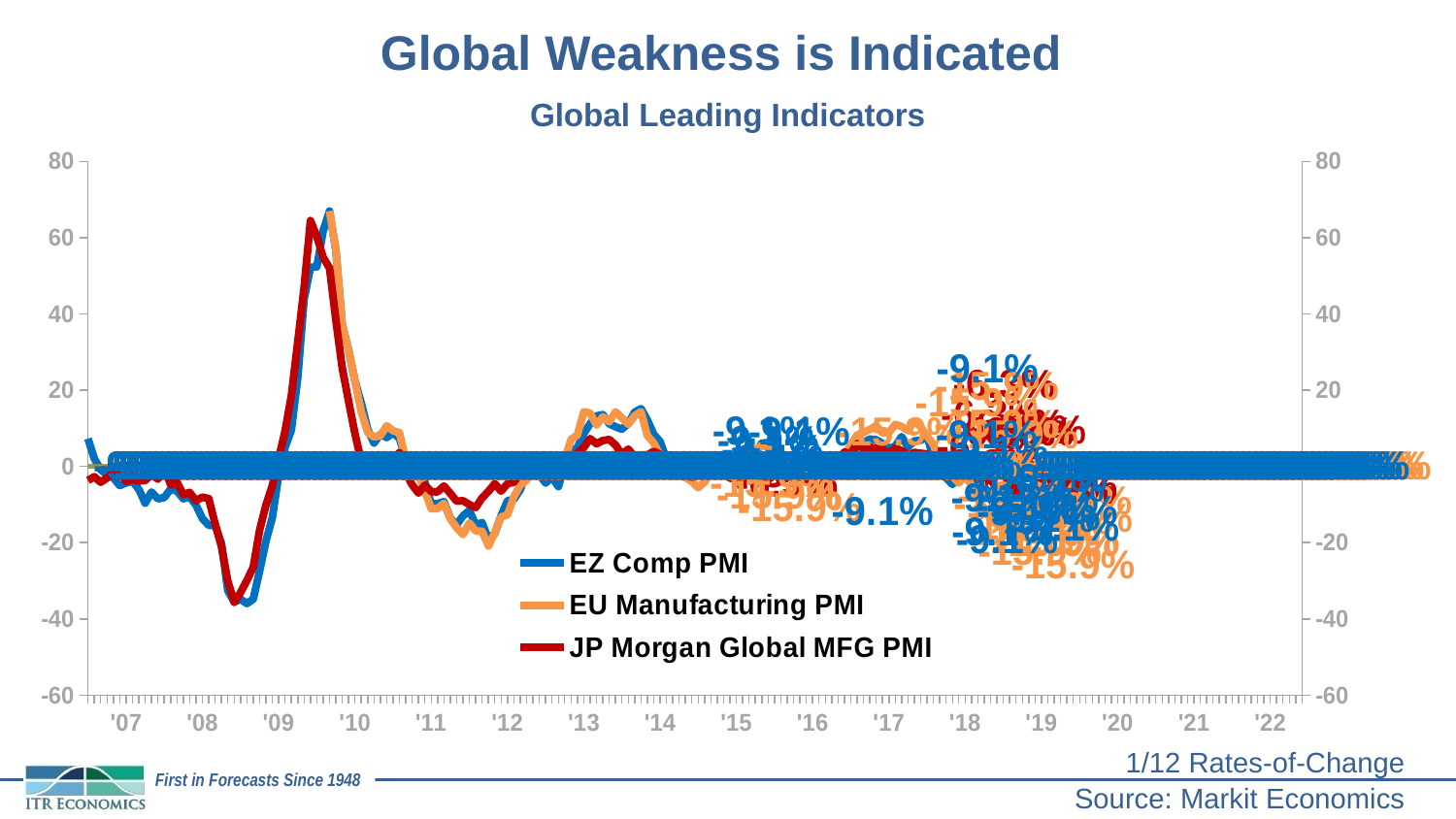
Is the peak value of JP Morgan Global MFG PMI around '09 greater or less than 40? greater What is the highest value shown on the y axis? 80 Which series is drawn in red in the chart? JP Morgan Global MFG PMI Do the series rise or fall from their trough around '08-'09 to their peak around '09-'10? rise How many series does the legend list? 3 Is the lowest value of EZ Comp PMI around '08-'09 greater or less than -20? less Around '13-'14, is the value of EZ Comp PMI greater or less than 40? less What is the title of the chart? Global Leading Indicators What kind of chart is shown on the slide? Line chart